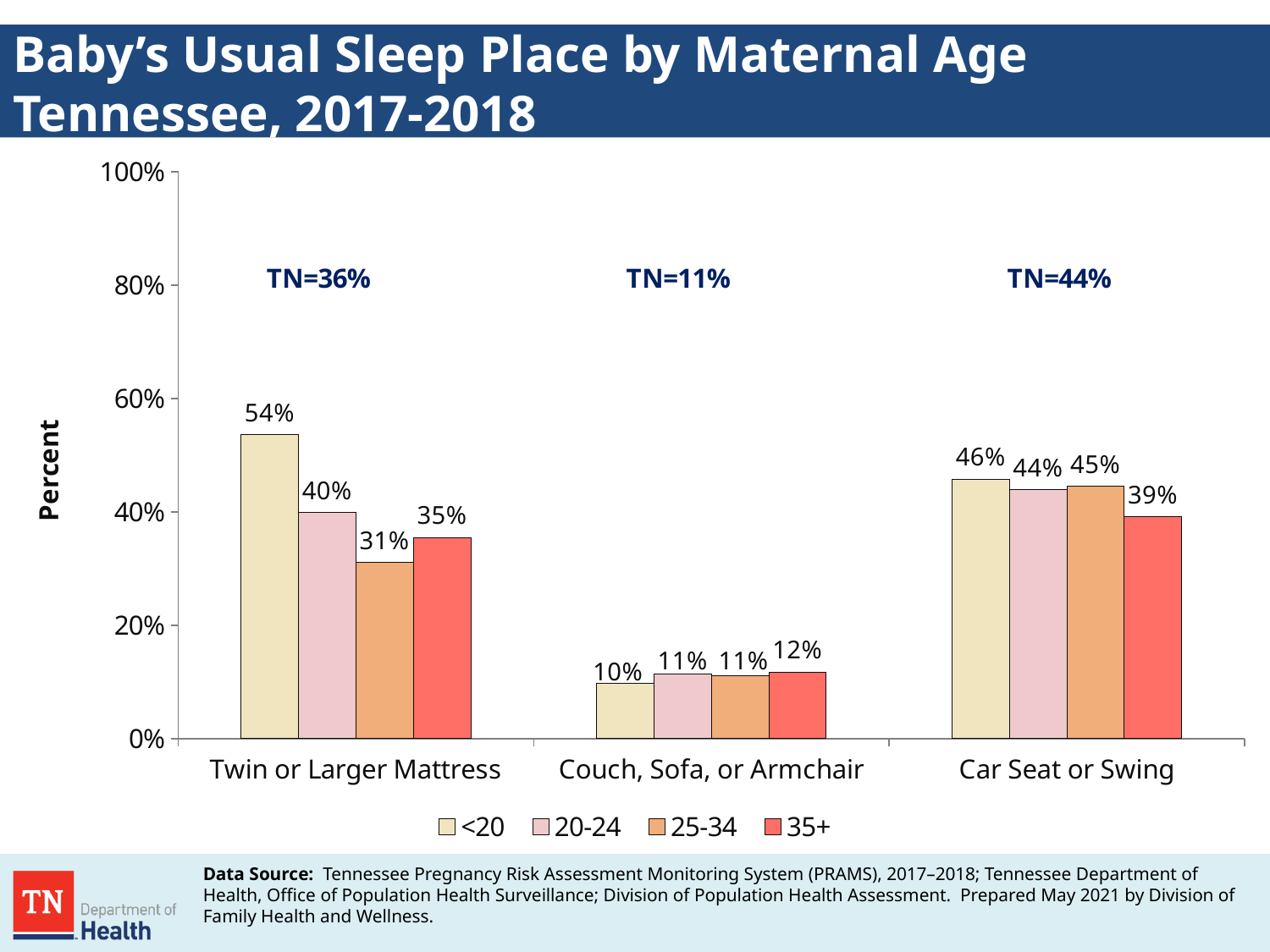
How many sleep place categories are shown on the x axis? 3 What is the difference between the <20 and 25-34 values for Twin or Larger Mattress? 23% What is the value for the 35+ maternal age group in the Car Seat or Swing category? 39% What is the value for the 25-34 group in the Couch, Sofa, or Armchair category? 11% Which maternal age group has the highest value for Twin or Larger Mattress? <20 How many maternal age groups does the legend list? 4 What is the Tennessee overall value shown for Couch, Sofa, or Armchair? TN=11% What percent of babies of mothers under 20 usually sleep on a twin or larger mattress? 54% What kind of chart is shown on the slide? Bar chart Which is larger for the 35+ group: Twin or Larger Mattress or Car Seat or Swing? Car Seat or Swing Which maternal age group has the lowest value for Twin or Larger Mattress? 25-34 What is the label on the y axis? Percent